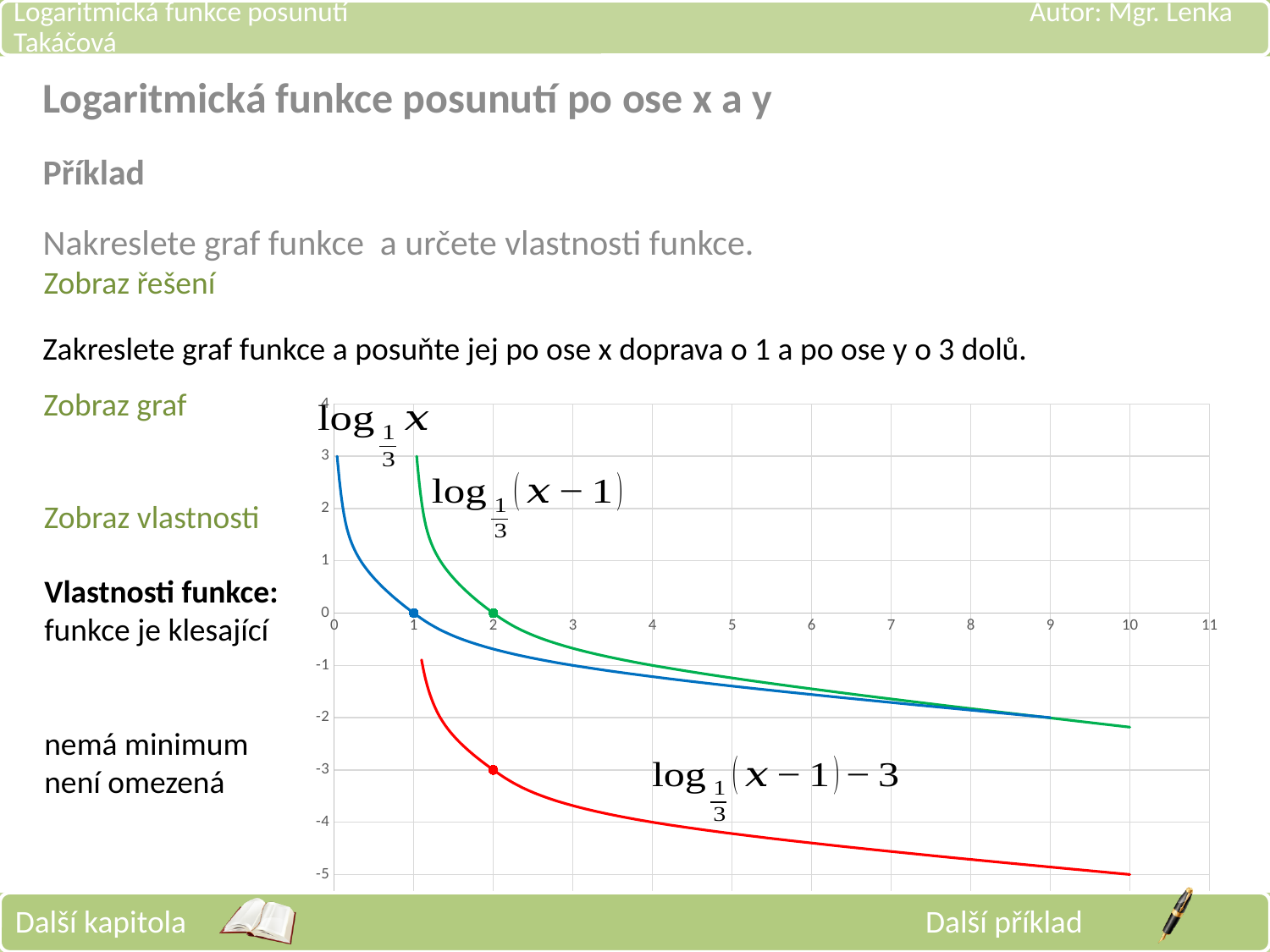
What kind of chart is shown on the slide? line chart At what x value does the green curve (log base 1/3 of (x − 1)) cross the x axis (y = 0)? 2 What colour is the curve labelled log base 1/3 of (x − 1)? green What is the y value of the marked point on the red curve (log base 1/3 of (x − 1) − 3) at x = 2? -3 At x = 5, which curve has the larger y value, the green curve or the red curve? the green curve Which of the three curves lies lowest on the chart? the red curve, log base 1/3 of (x − 1) − 3 Is the value of the red curve at x = 8 greater or less than -4? less How many curves are plotted on the chart? 3 Is the value of the blue curve at x = 3 greater or less than -2? greater Do the plotted curves rise or fall as x increases? fall At what x value does the blue curve (log base 1/3 of x) cross the x axis (y = 0)? 1 What is the highest value shown on the y axis of the chart? 4